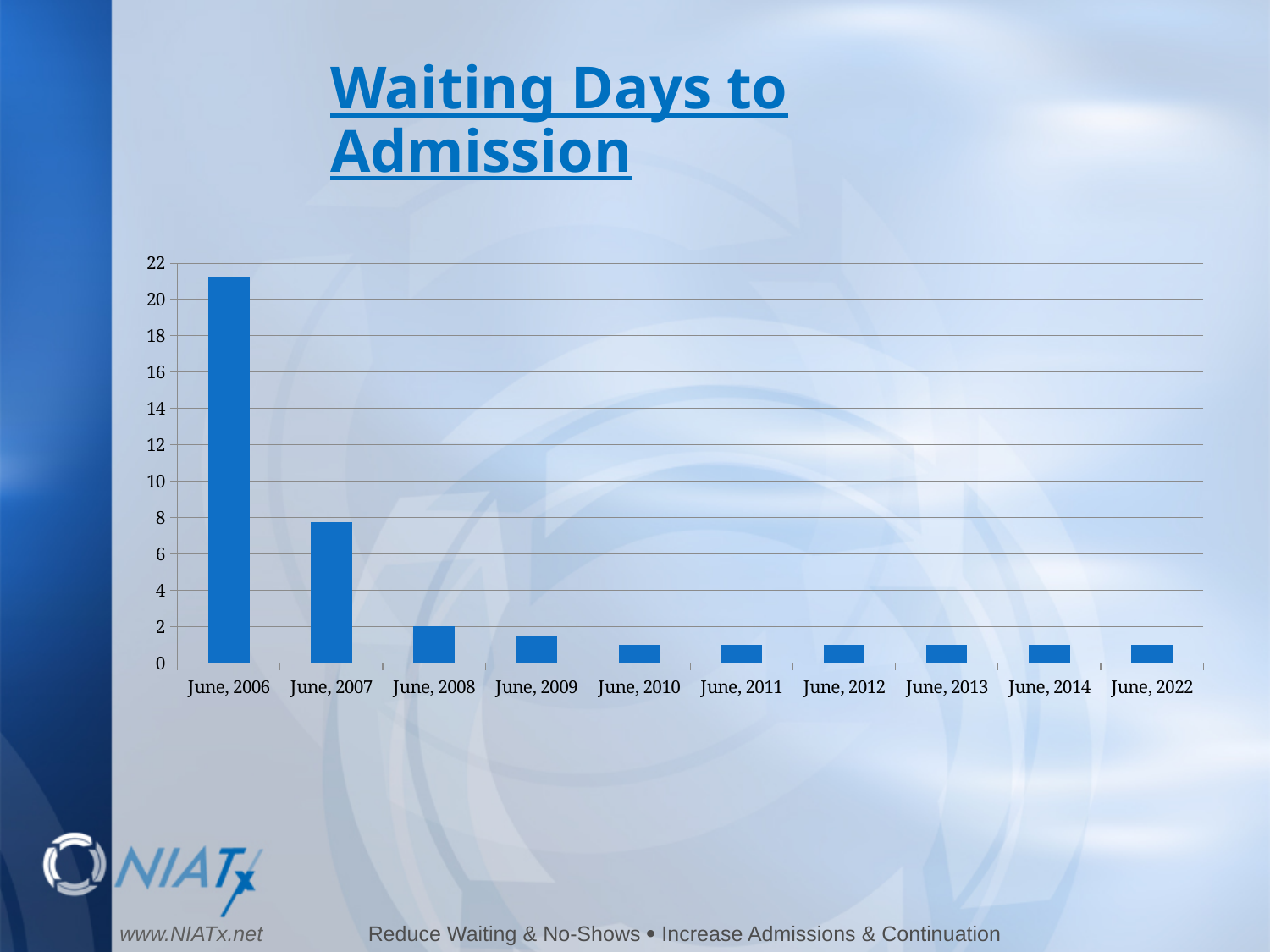
Is the value for June, 2007 greater or less than 10? less What kind of chart is shown on the slide? bar chart Which category has the highest value? June, 2006 Is the value for June, 2008 greater or less than 4? less Do the values generally rise or fall from June, 2006 to June, 2022? fall Is the value for June, 2006 greater or less than 20? greater How many categories are plotted on the x axis? 10 Which is larger, the value for June, 2006 or the value for June, 2007? June, 2006 What is the title of the chart? Waiting Days to Admission Which is larger, the value for June, 2007 or the value for June, 2008? June, 2007